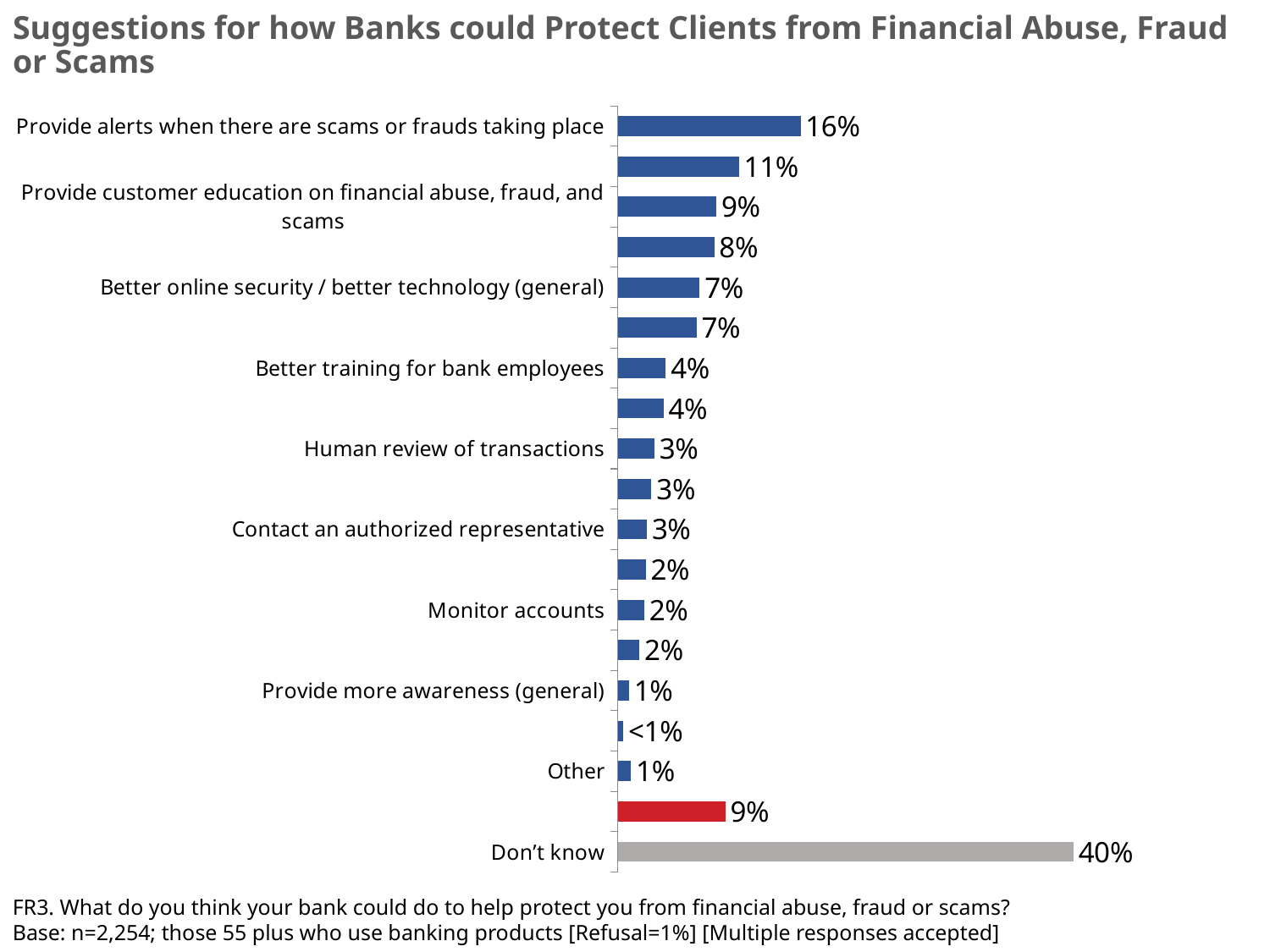
What value is shown on the red bar? 9% Which is larger: the value for 'Provide alerts when there are scams or frauds taking place' or the value for 'Provide customer education on financial abuse, fraud, and scams'? Provide alerts when there are scams or frauds taking place What is the difference between the value for 'Don't know' and the value for 'Provide alerts when there are scams or frauds taking place'? 24 percentage points What colour is the bar for 'Don't know'? Gray What is the value for 'Better online security / better technology (general)'? 7% What type of chart is shown? Bar chart How many bars are plotted in the chart? 19 What is the value for 'Don't know'? 40% What is the value for 'Better training for bank employees'? 4% What is the value for 'Monitor accounts'? 2% What percentage of respondents suggested 'Provide alerts when there are scams or frauds taking place'? 16% Which category has the highest value? Don't know